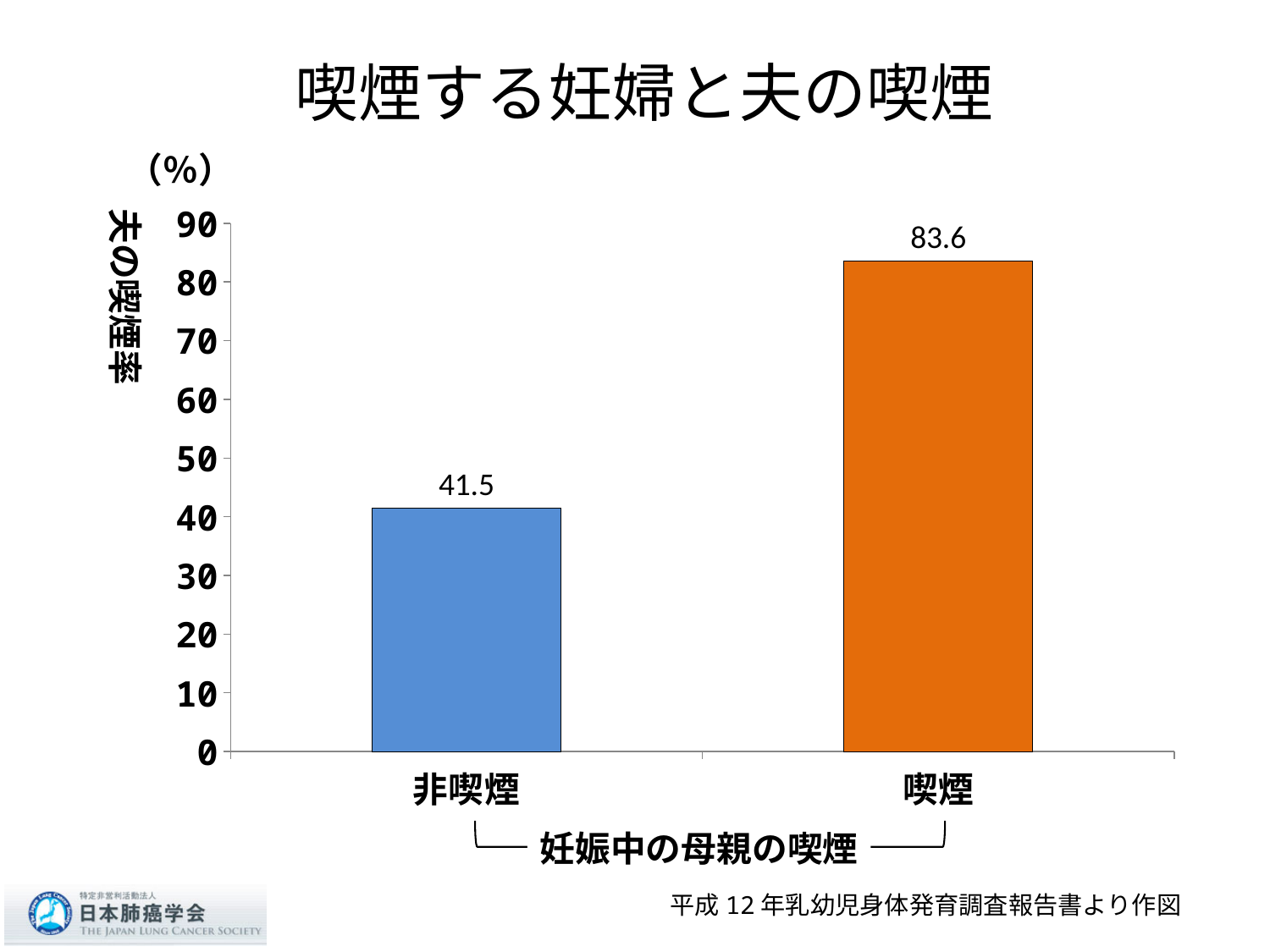
What kind of chart is shown on the slide? bar chart What is the label of the y axis? 夫の喫煙率 Which is larger, the value for 非喫煙 or the value for 喫煙? 喫煙 What is the difference between the values for 喫煙 and 非喫煙? 42.1 What is the value for 非喫煙? 41.5 Which category has the lowest value? 非喫煙 Which category has the highest value? 喫煙 What is the title of the chart? 喫煙する妊婦と夫の喫煙 How many categories are shown on the x axis? 2 What is the value for 喫煙? 83.6 Is the value for 非喫煙 greater or less than 50? less Is the value for 喫煙 greater or less than 80? greater